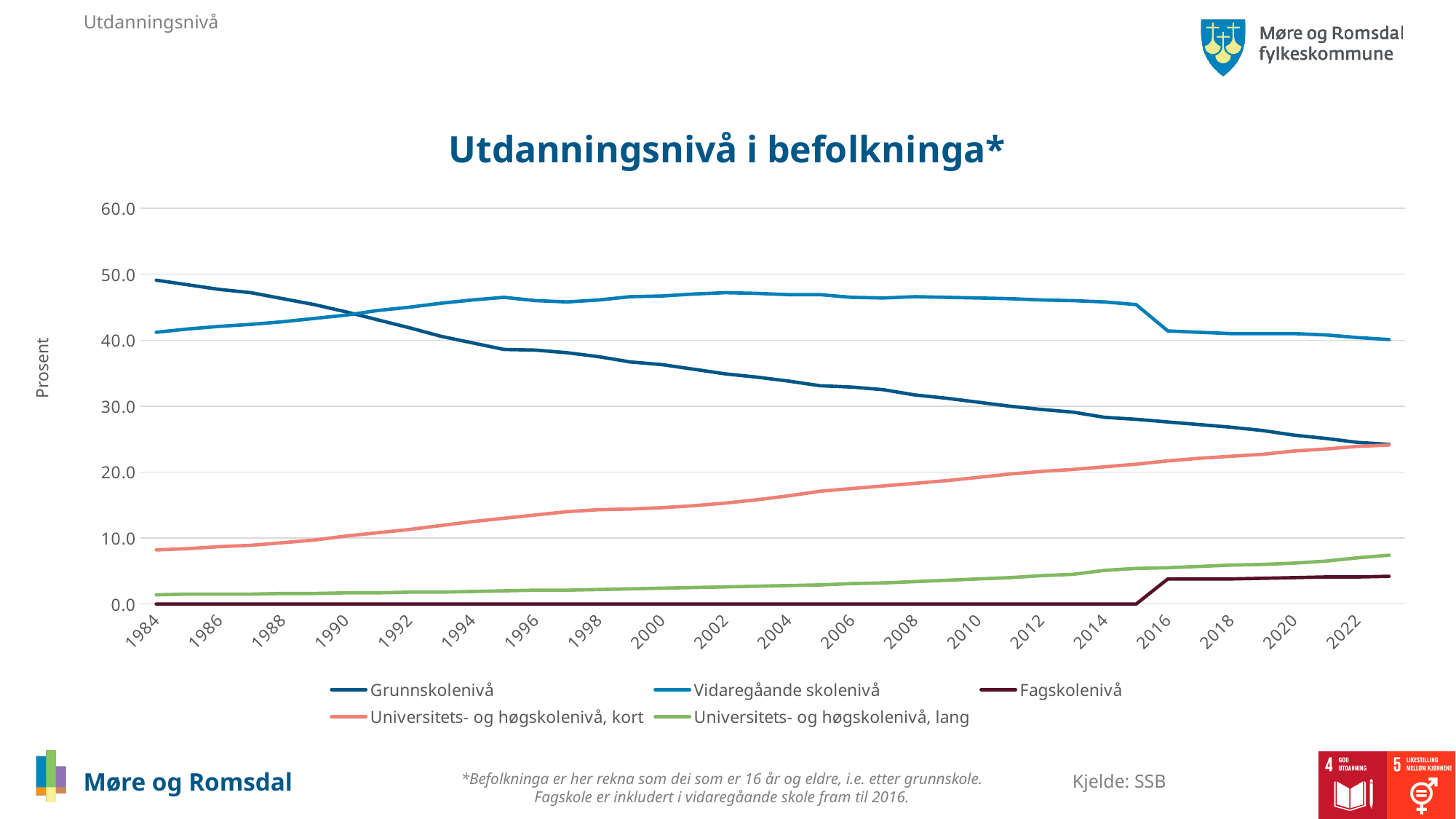
What is the label on the y axis? Prosent Is the value for Vidaregåande skolenivå in 2000 greater or less than 40.0? greater Is the value for Universitets- og høgskolenivå, lang in 2022 greater or less than 10.0? less Is the value for Grunnskolenivå in 1984 greater or less than 40.0? greater In 1984, which is higher: Grunnskolenivå or Vidaregåande skolenivå? Grunnskolenivå What is the title of the chart? Utdanningsnivå i befolkninga* Does the value for Grunnskolenivå rise or fall from 1984 to 2022? fall Does the value for Universitets- og høgskolenivå, kort rise or fall from 1984 to 2022? rise Which series has the highest value in 2022? Vidaregåande skolenivå How many series does the legend list? 5 What kind of chart is shown on the slide? line chart